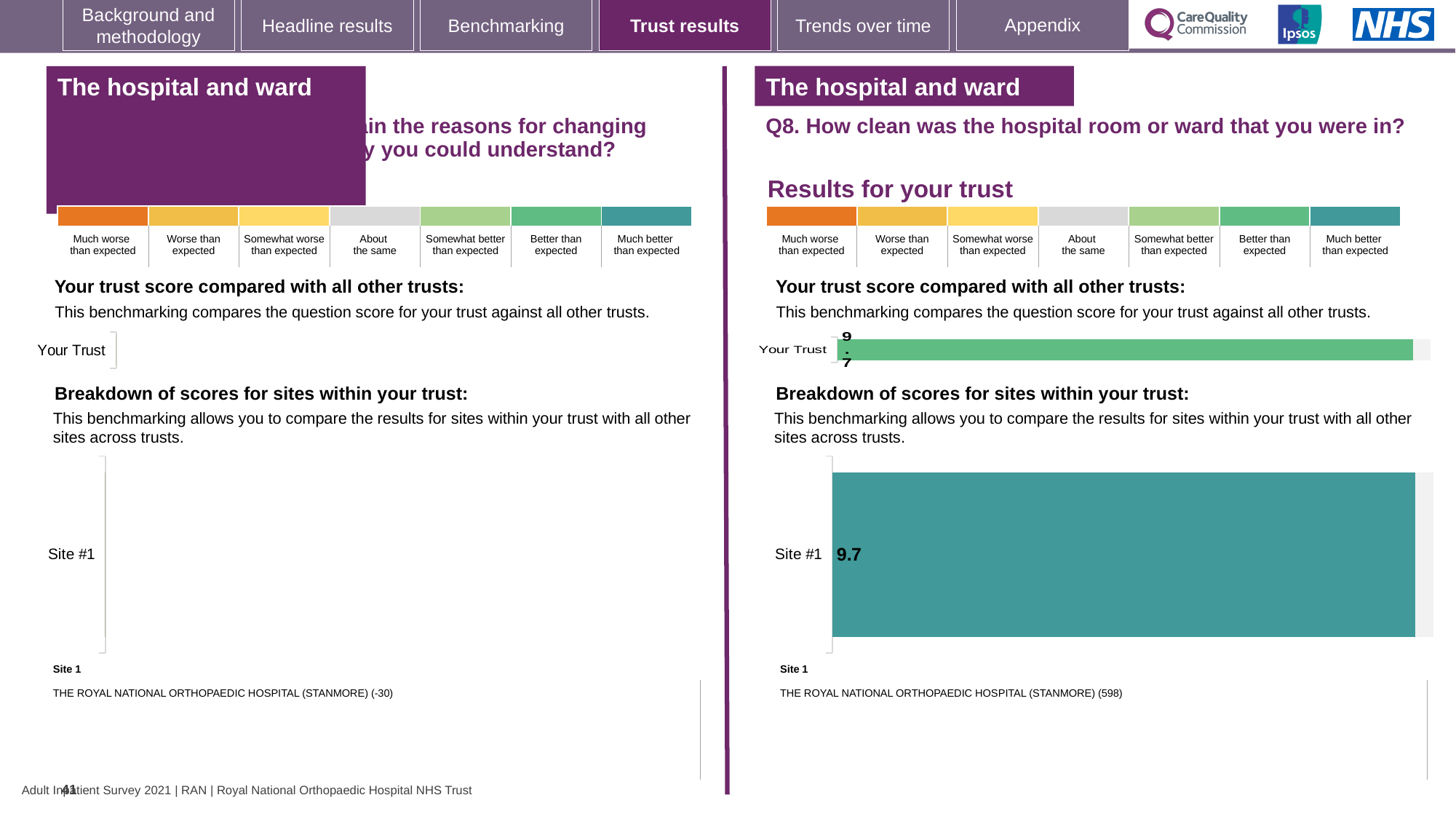
How many bars are plotted in the 'Your trust score compared with all other trusts' chart on the right-hand panel? 1 On the right-hand panel, which hospital is listed as Site 1 beneath the site breakdown chart? THE ROYAL NATIONAL ORTHOPAEDIC HOSPITAL (STANMORE) (598) On the right-hand slide panel (Q8), what score is shown for Site #1 in the 'Breakdown of scores for sites within your trust' chart? 9.7 On the right-hand panel, is the Site #1 score of 9.7 greater or less than 9? greater On the right-hand slide panel (Q8), what score is shown for Your Trust in the 'Your trust score compared with all other trusts' chart? 9.7 What kind of chart is used to show the Site #1 score on the right-hand panel of the slide? Bar chart Which survey question do the charts on the right-hand panel of the slide relate to? Q8. How clean was the hospital room or ward that you were in? How many sites are plotted in the 'Breakdown of scores for sites within your trust' chart on the right-hand panel? 1